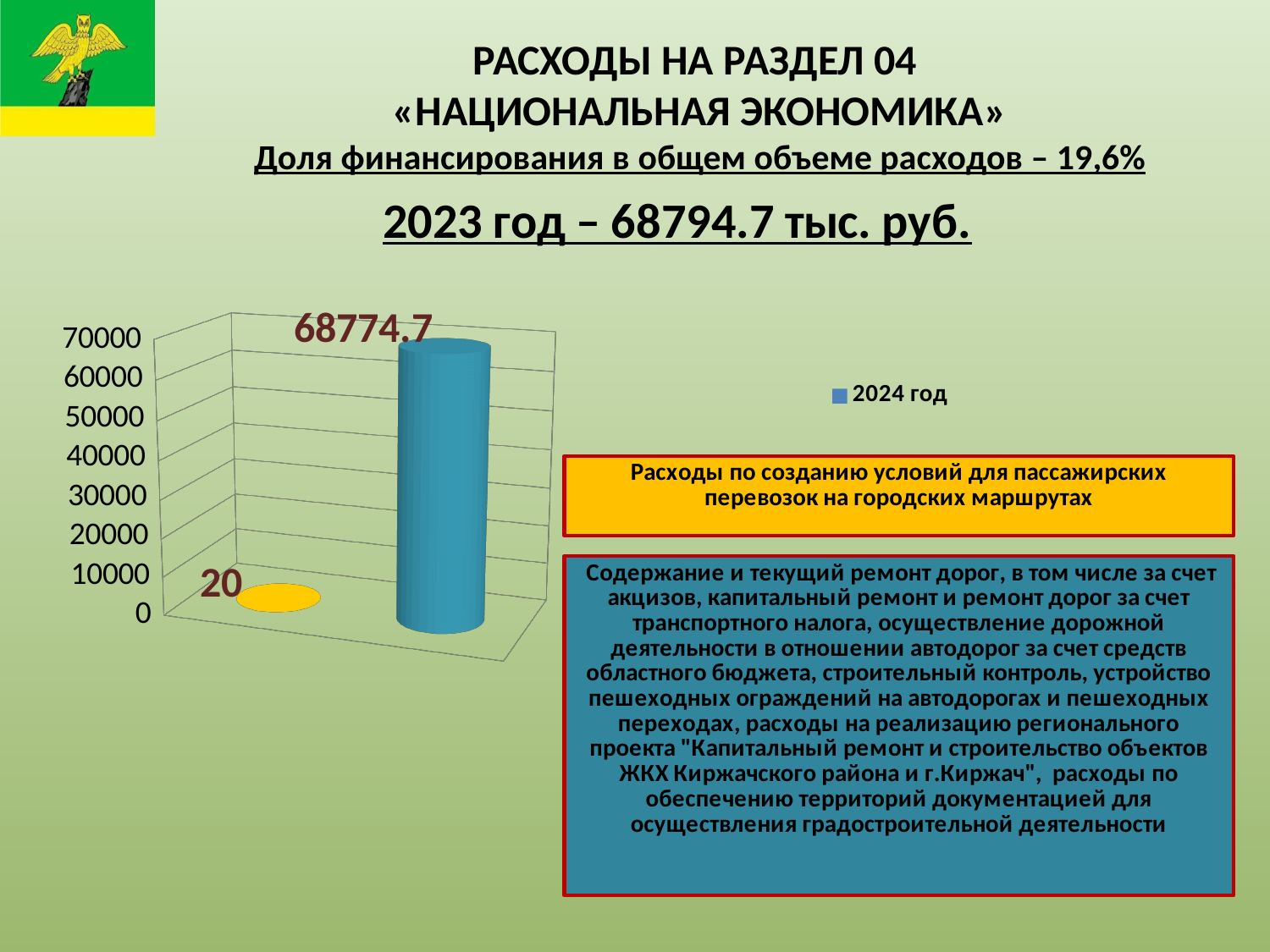
What kind of chart is shown on the slide? Bar chart Which is larger, the blue bar or the yellow bar? The blue bar Is the value of the yellow bar greater or less than 10000? less How many bars are plotted in the chart? 2 What value is shown on the data label of the yellow bar in the chart? 20 What is the legend entry shown next to the chart? 2024 год What value is shown on the data label of the blue bar in the chart? 68774.7 How many series does the chart legend list? 1 What is the difference between the blue bar's value and the yellow bar's value? 68754.7 Is the value of the blue bar greater or less than 60000? greater Which bar in the chart has the lowest value? The yellow bar (20) Which bar in the chart has the highest value? The blue bar (68774.7)